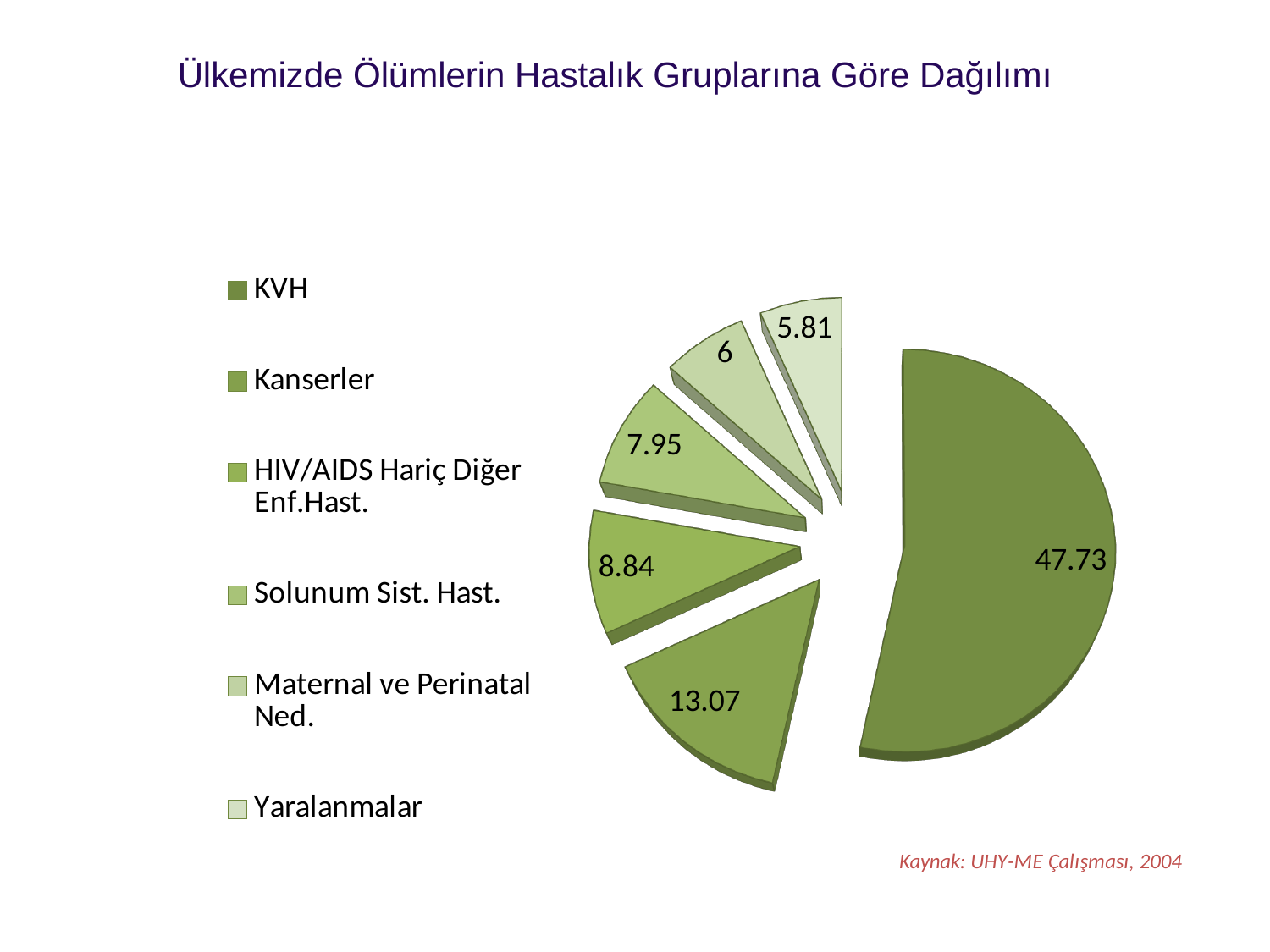
What kind of chart is shown on the slide? pie chart How many categories does the pie chart have? 6 What is the difference between the values for KVH and Kanserler? 34.66 What is the value for Yaralanmalar? 5.81 What is the value for Maternal ve Perinatal Ned.? 6 What is the value for KVH? 47.73 What is the value for Kanserler? 13.07 What is the value for Solunum Sist. Hast.? 7.95 What is the title of the chart? Ülkemizde Ölümlerin Hastalık Gruplarına Göre Dağılımı Which category has the largest slice? KVH Which category has the smallest slice? Yaralanmalar Which is larger, the value for HIV/AIDS Hariç Diğer Enf.Hast. or the value for Solunum Sist. Hast.? HIV/AIDS Hariç Diğer Enf.Hast.